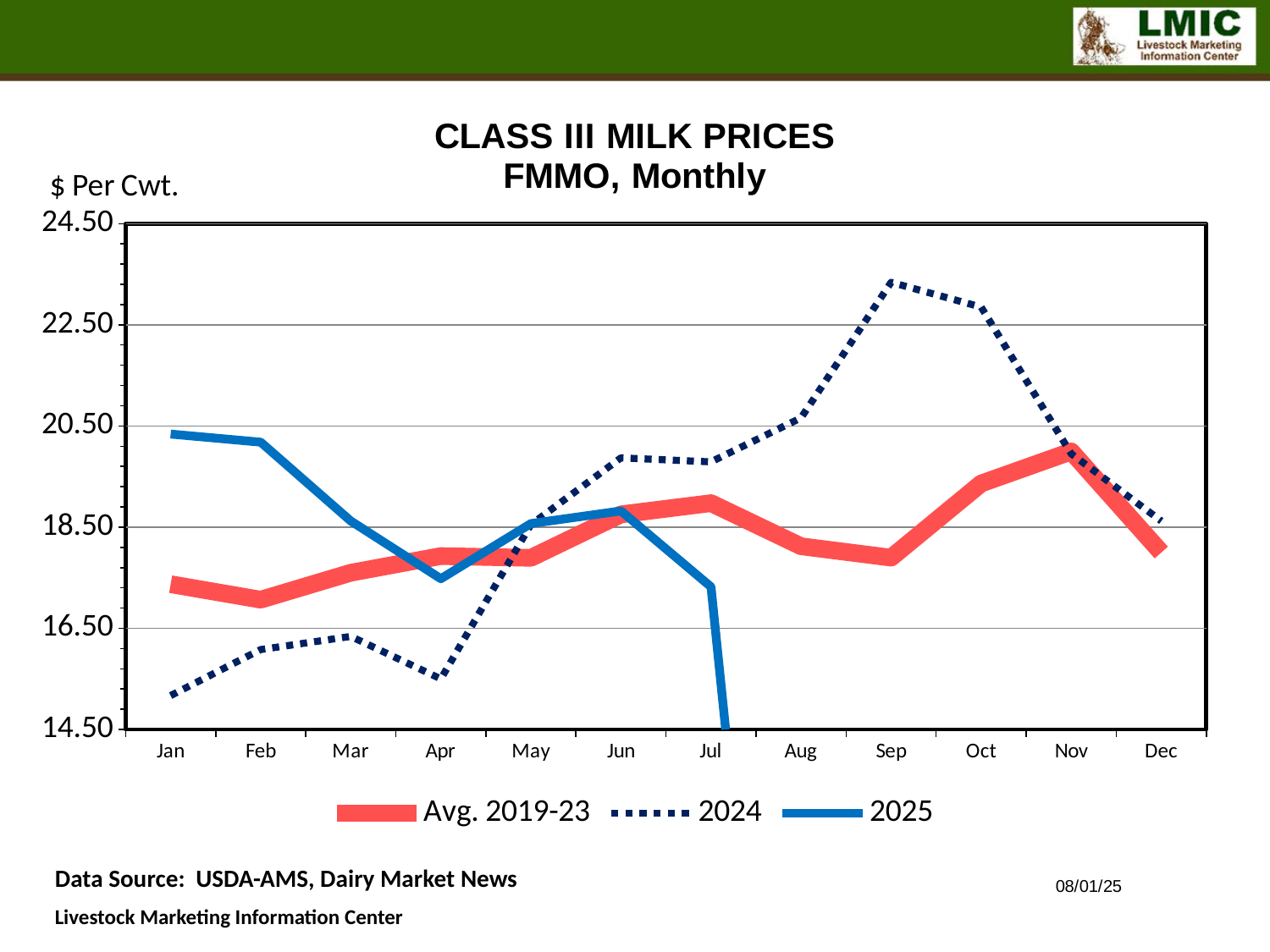
What kind of chart is shown on the slide? line chart Is the 2024 value for Jan greater or less than 16.50? less How many months are shown along the x axis? 12 Which series has the higher value in Jan, 2024 or 2025? 2025 Is the 2025 value for Jan greater or less than 18.50? greater Is the 2024 value for Sep greater or less than 22.50? greater In which month does the Avg. 2019-23 series reach its highest value? Nov In which month does the 2024 series reach its highest value? Sep How many series does the legend list? 3 Does the 2024 series rise or fall from Jan to Sep? rise What unit is shown on the y axis label? $ Per Cwt. In which month is the 2024 series at its lowest value? Jan